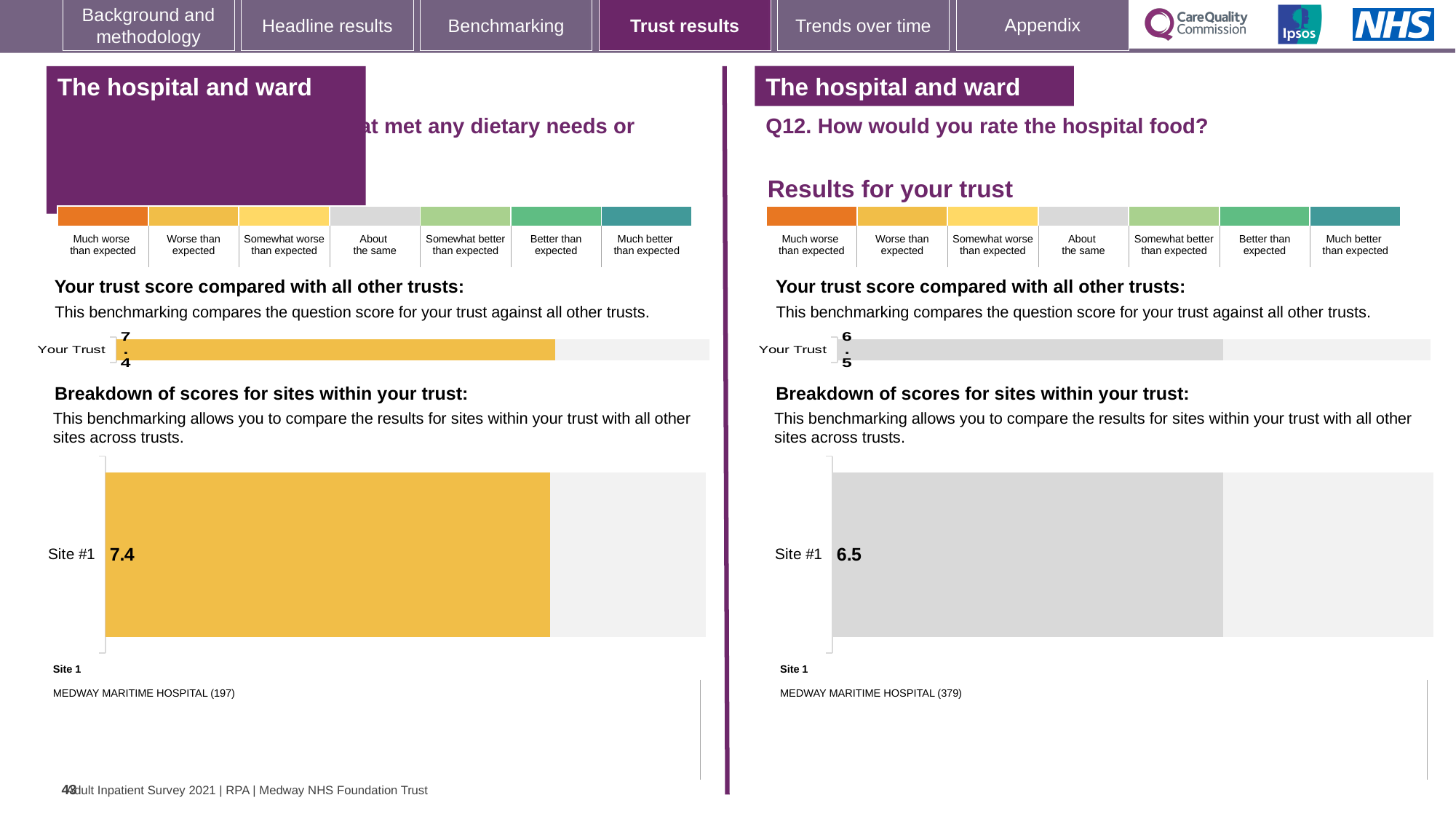
What is the difference between the Site #1 score on the left-hand site breakdown chart and the Site #1 score on the right-hand Q12 site breakdown chart? 0.9 On the right-hand 'Breakdown of scores for sites within your trust' chart for Q12, what is the score for Site #1? 6.5 Which is larger: the Site #1 score on the left-hand site breakdown chart or the Site #1 score on the right-hand Q12 site breakdown chart? Left-hand chart (7.4) How many sites are shown on the right-hand 'Breakdown of scores for sites within your trust' chart for Q12? 1 On the left-hand 'Your trust score compared with all other trusts' chart, what is the 'Your Trust' score? 7.4 Is the 'Your Trust' score on the right-hand Q12 chart greater or less than 7? less On the right-hand chart for Q12 'How would you rate the hospital food?', what is the 'Your Trust' score? 6.5 What kind of chart is the 'Breakdown of scores for sites within your trust' chart on the left-hand side? Bar chart On the right-hand Q12 'Your Trust' chart, which benchmark category does the grey bar colour correspond to in the key? About the same On the right-hand Q12 site breakdown chart, which site is listed as Site 1? MEDWAY MARITIME HOSPITAL (379) On the left-hand 'Breakdown of scores for sites within your trust' chart, what is the score for Site #1? 7.4